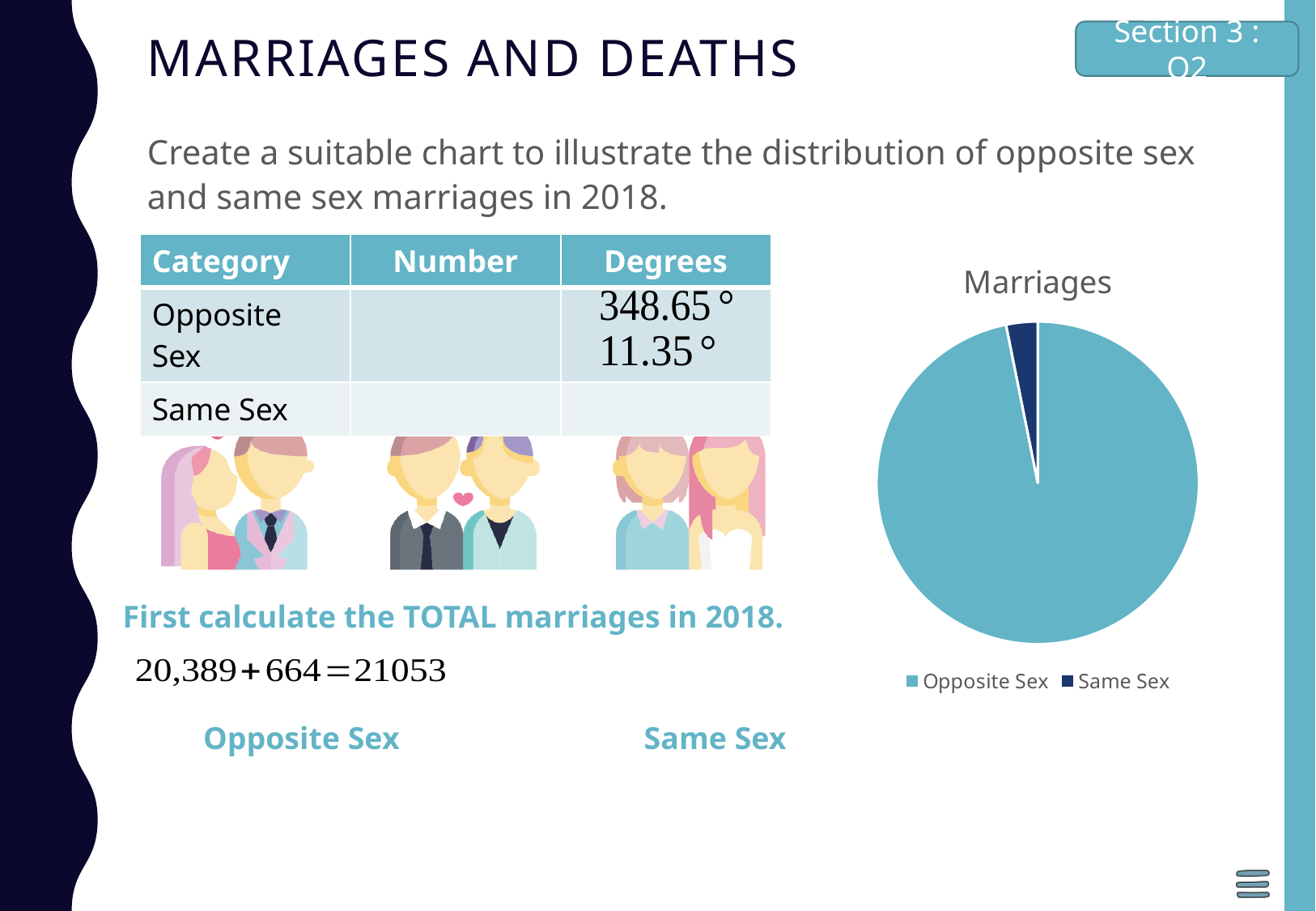
How many slices does the Marriages pie chart have? 2 Does the Opposite Sex slice take up more or less than half of the Marriages pie chart? more Which category has the largest slice in the Marriages pie chart? Opposite Sex What kind of chart is shown on the slide? pie chart How many entries does the legend of the Marriages pie chart list? 2 What is the title of the chart on the slide? Marriages In the Marriages pie chart, which slice is larger: Opposite Sex or Same Sex? Opposite Sex Which category has the smallest slice in the Marriages pie chart? Same Sex What colour is the Same Sex slice in the Marriages pie chart? dark navy blue